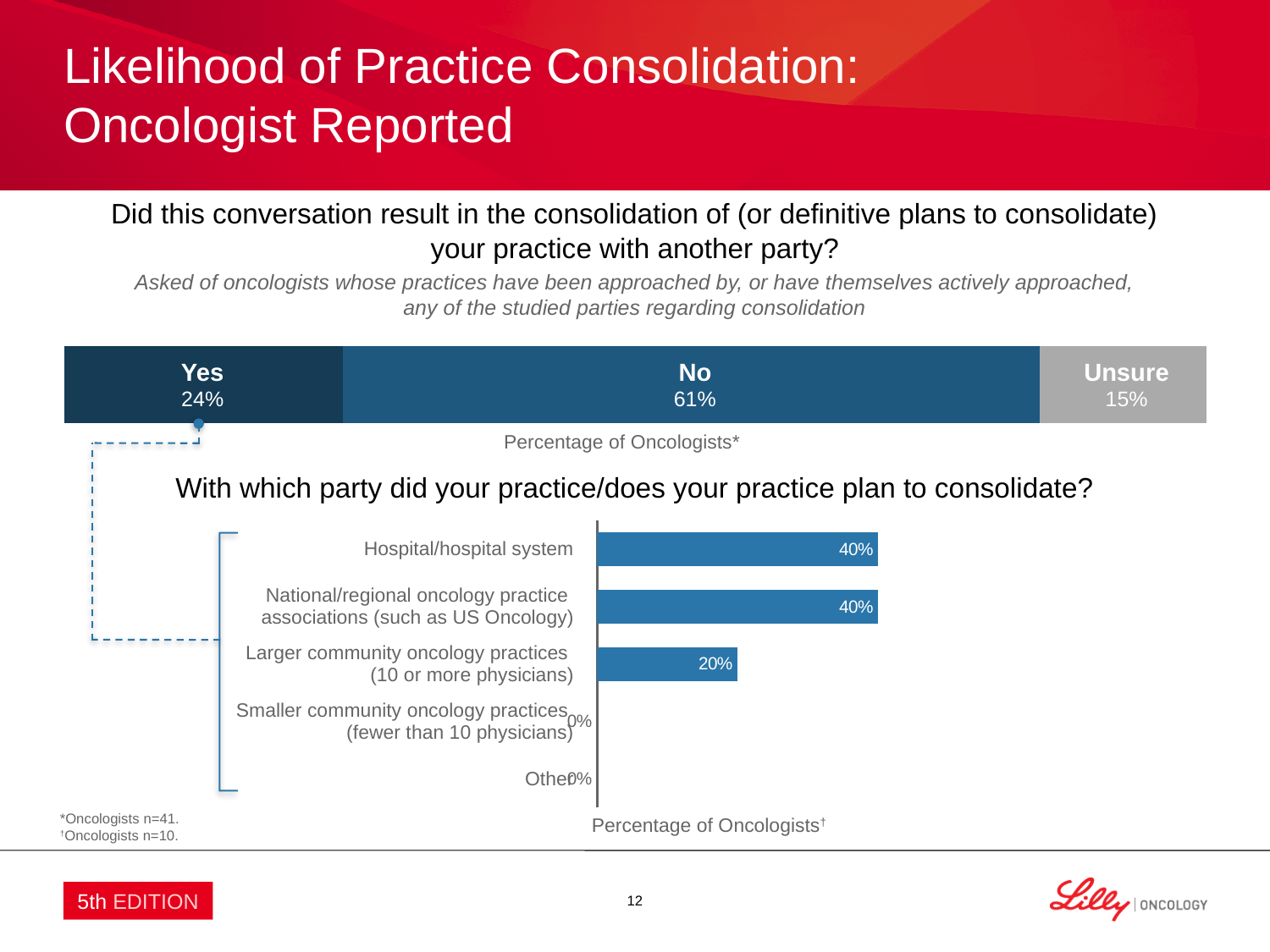
In the top stacked bar chart, what percentage of oncologists answered "Yes"? 24% In the lower chart, what is the value for Smaller community oncology practices (fewer than 10 physicians)? 0% In the lower chart, which is larger: Hospital/hospital system or Larger community oncology practices? Hospital/hospital system In the lower chart, what is the value for Larger community oncology practices (10 or more physicians)? 20% In the lower chart, what is the difference between the values for National/regional oncology practice associations and Larger community oncology practices? 20% In the top stacked bar chart, what percentage of oncologists answered "No"? 61% In the top stacked bar chart, which response has the smallest share? Unsure In the lower chart titled "With which party did your practice/does your practice plan to consolidate?", what is the value for Hospital/hospital system? 40% What kind of chart is the lower chart on the slide? Bar chart In the top stacked bar chart, what do the three segments add up to? 100% In the top stacked bar chart, what is the difference between the "No" and "Yes" percentages? 37% In the lower chart, how many categories are plotted? 5